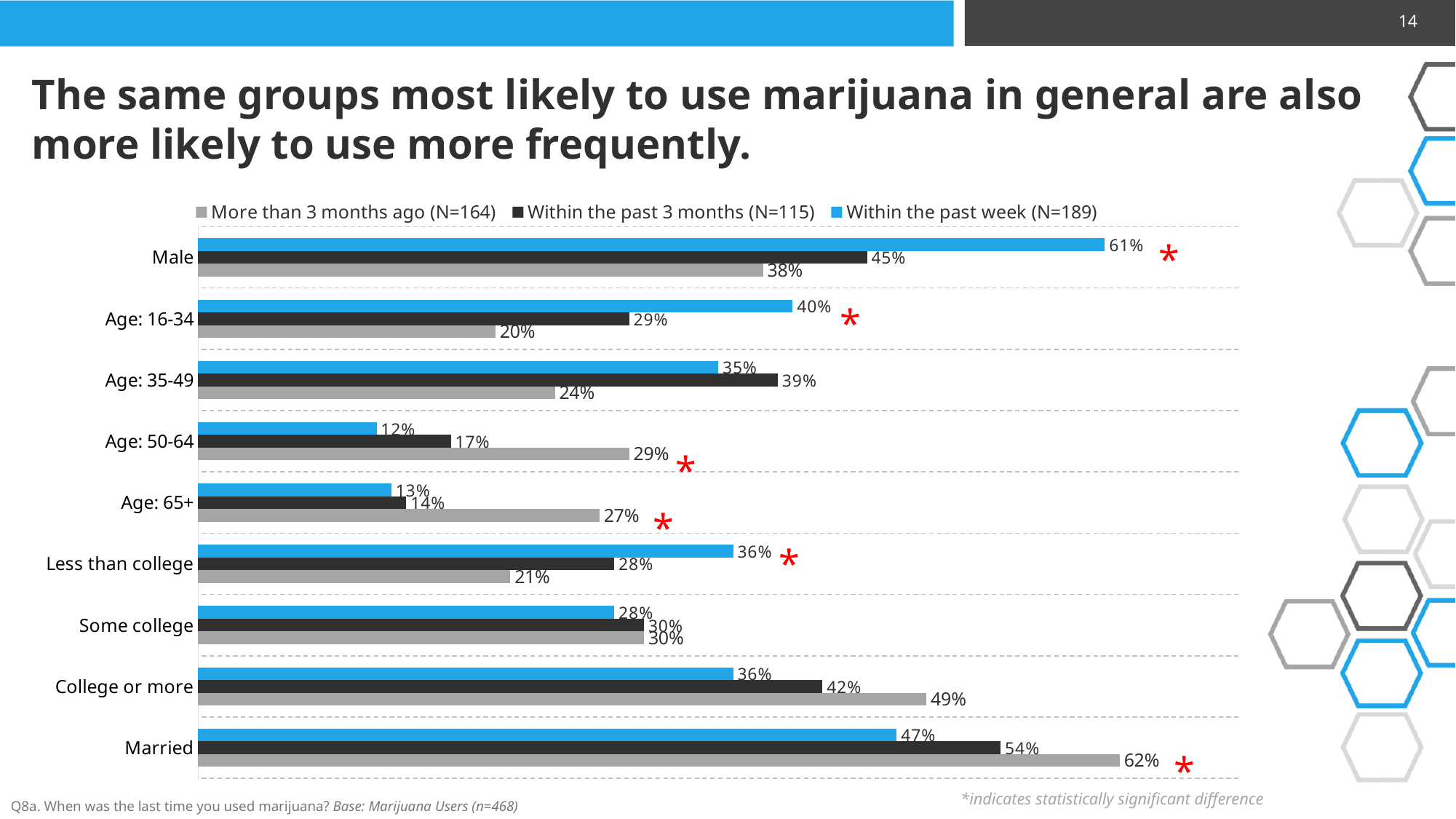
What kind of chart is shown on the slide? Bar chart What is the value for Some college in the 'Within the past week (N=189)' series? 28% Which category has the highest value in the 'Within the past week (N=189)' series? Male Which colour represents the 'Within the past week (N=189)' series? Blue How many categories are shown on the chart? 9 What is the value for Married in the 'More than 3 months ago (N=164)' series? 62% What is the value for Male in the 'Within the past week (N=189)' series? 61% What is the value for Age: 35-49 in the 'Within the past 3 months (N=115)' series? 39% How many series does the legend list? 3 Which category has the lowest value in the 'Within the past week (N=189)' series? Age: 50-64 What is the difference between the 'Within the past week' and 'More than 3 months ago' values for Male? 23% For College or more, which is larger: the 'More than 3 months ago' value or the 'Within the past week' value? More than 3 months ago